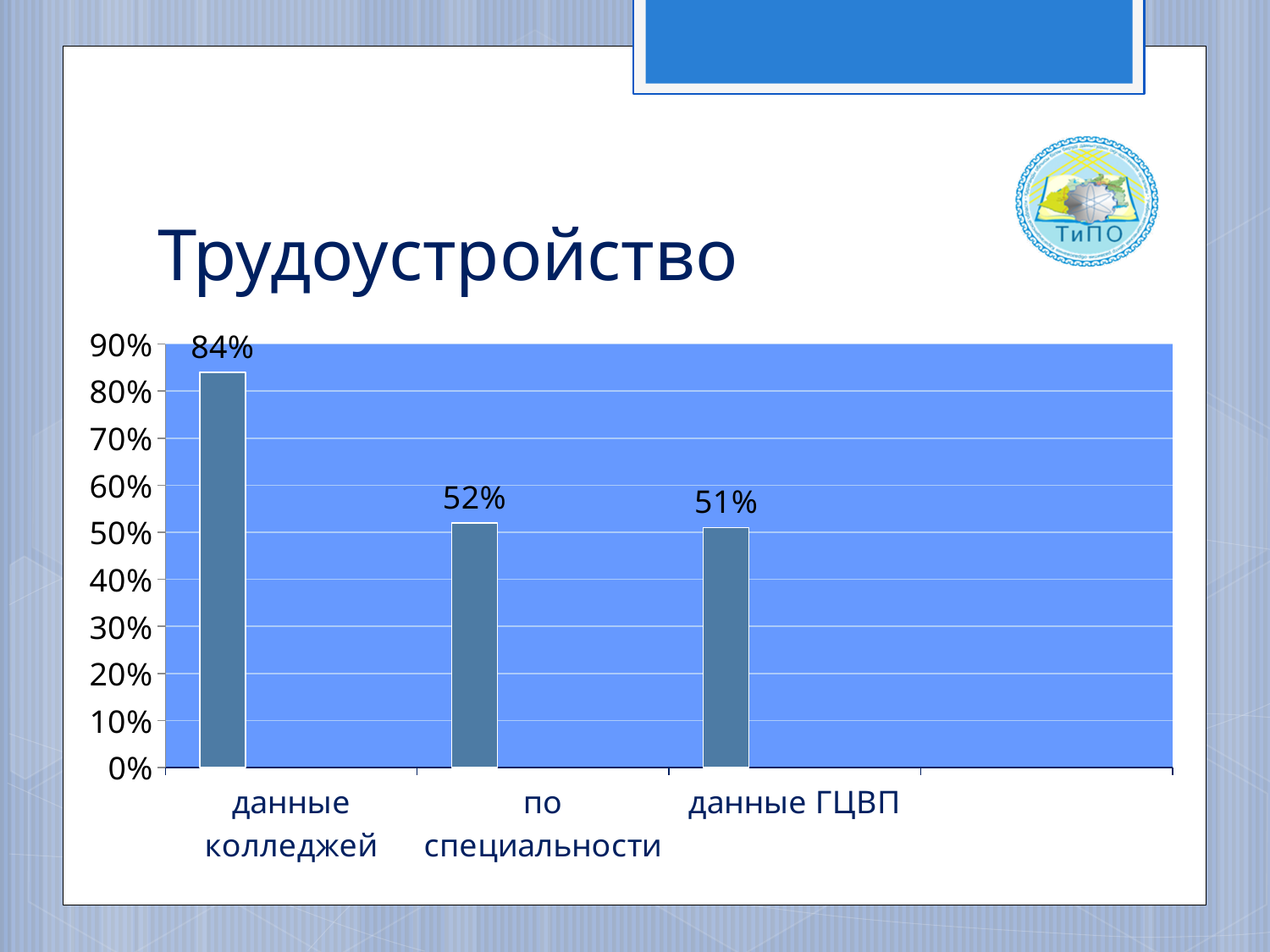
What is the difference between the values for данные колледжей and по специальности? 32% Which category has the highest value? данные колледжей Which category has the lowest value? данные ГЦВП Is the value for данные колледжей greater or less than 80%? greater What is the difference between the values for по специальности and данные ГЦВП? 1% How many bars are plotted in the chart? 3 What kind of chart is shown on the slide? bar chart What is the title of the slide above the chart? Трудоустройство What is the value for по специальности? 52% Which is larger, the value for данные колледжей or the value for данные ГЦВП? данные колледжей What is the value for данные ГЦВП? 51% What is the value for данные колледжей? 84%